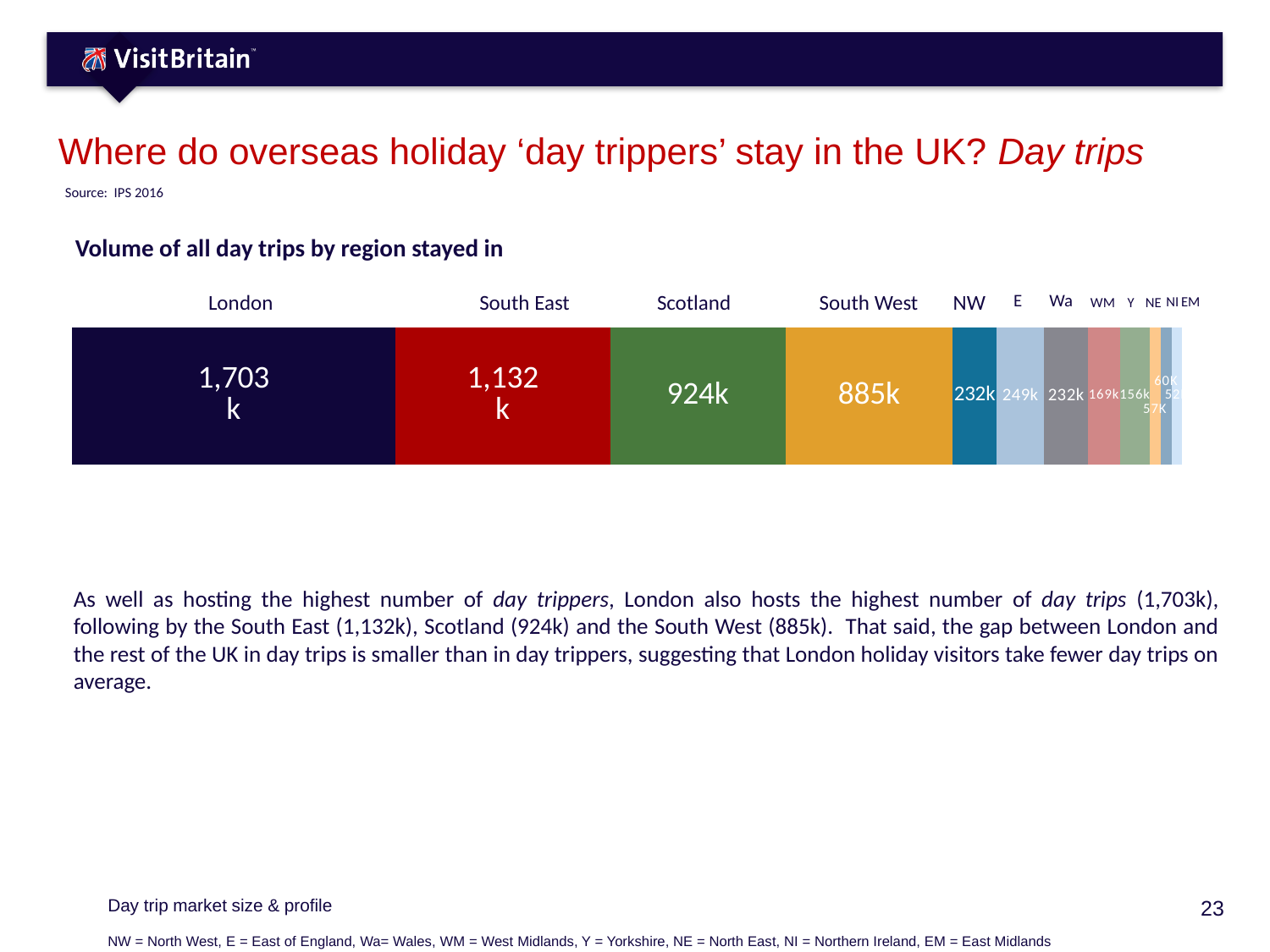
What is the volume of day trips for London? 1,703k What is the volume of day trips for WM (West Midlands)? 169k What is the volume of day trips for the South East? 1,132k How many regions are shown in the chart? 12 What is the volume of day trips for E (East of England)? 249k What is the title of the chart? Volume of all day trips by region stayed in Which region has the highest volume of day trips? London Which has more day trips, E (East of England) or NW (North West)? E (East of England) What is the difference in day trips between Scotland and the South West? 39k What is the volume of day trips for the South West? 885k What is the volume of day trips for Scotland? 924k What is the difference in day trips between London and the South East? 571k